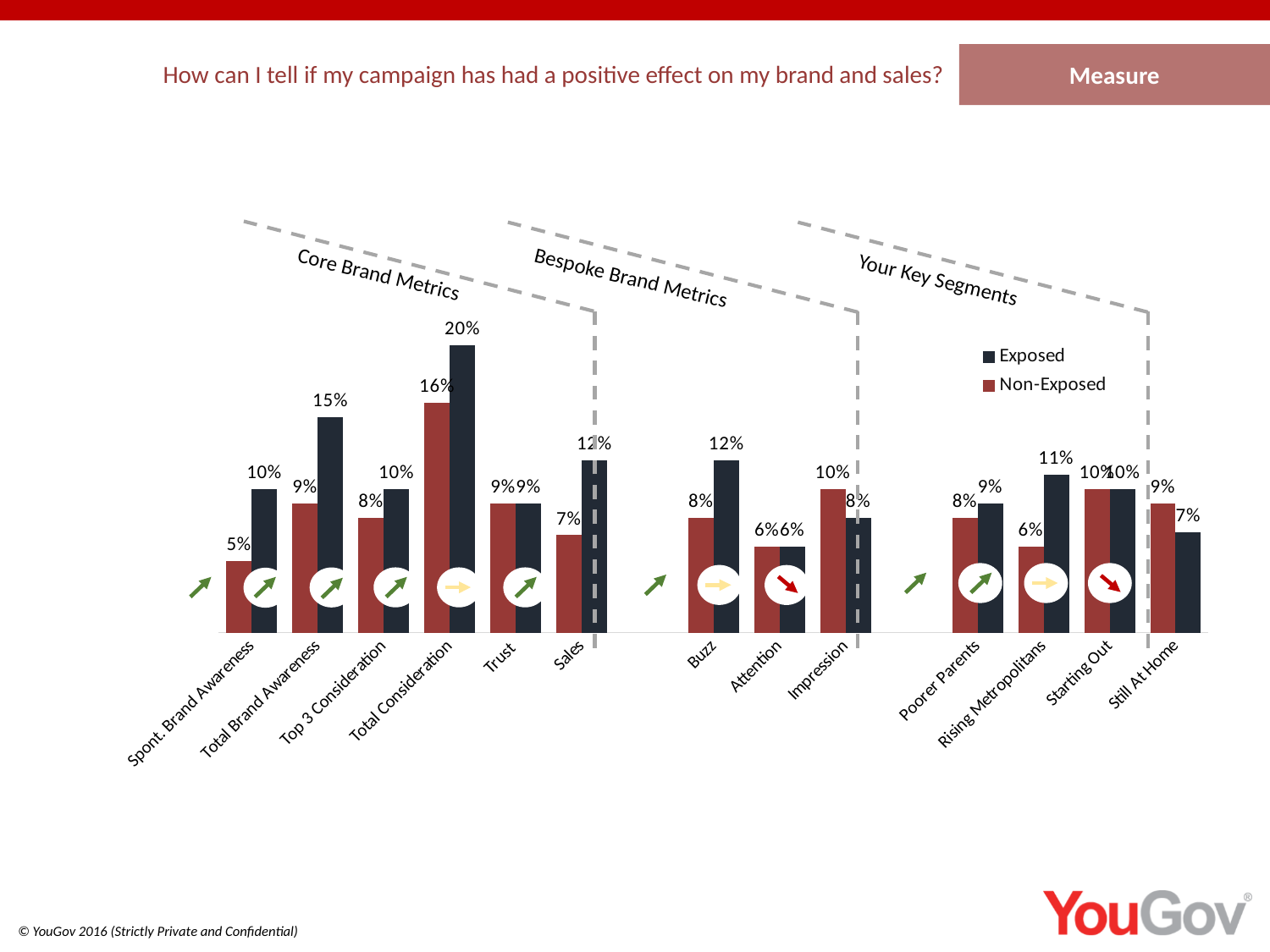
What is the difference between the Exposed and Non-Exposed values for Sales? 5% What is the difference between the Exposed and Non-Exposed values for Total Brand Awareness? 6% What is the Non-Exposed value for Spont. Brand Awareness? 5% What are the two series named in the legend? Exposed and Non-Exposed What is the Exposed value for Rising Metropolitans? 11% Which category has the lowest Non-Exposed value? Spont. Brand Awareness Which category has the highest Exposed value? Total Consideration How many categories are shown along the x axis? 13 What kind of chart is shown on the slide? bar chart For Impression, which is larger: the Exposed value or the Non-Exposed value? Non-Exposed How many series does the legend list? 2 What is the Exposed value for Total Consideration? 20%